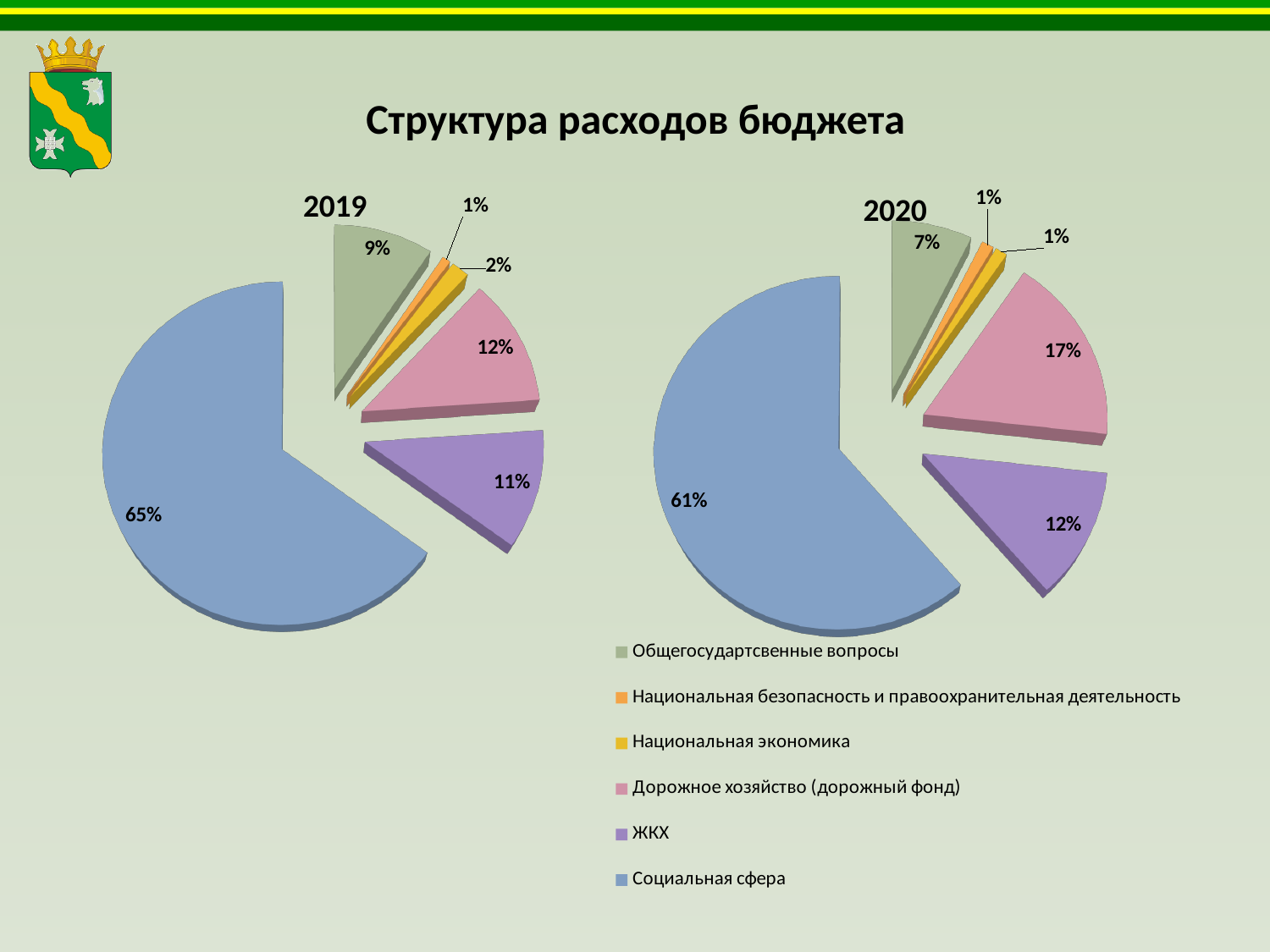
On the 2019 pie chart, which category has the smallest share? Национальная безопасность и правоохранительная деятельность On the 2020 pie chart, what share does Дорожное хозяйство (дорожный фонд) have? 17% What is the title of the slide's charts? Структура расходов бюджета How many categories does the legend list? 6 On the 2020 pie chart, which category has the largest share? Социальная сфера On the 2019 pie chart, what share does ЖКХ have? 11% On the 2019 pie chart, what share does Социальная сфера have? 65% On the 2019 pie chart, what share does Общегосудартсвенные вопросы have? 9% On the 2020 pie chart, what share does Социальная сфера have? 61% What kind of chart is used for the 2019 and 2020 data? Pie chart What is the difference between the share of Дорожное хозяйство (дорожный фонд) in 2020 and in 2019? 5% On the 2019 pie chart, which is larger: the share of Дорожное хозяйство (дорожный фонд) or the share of ЖКХ? Дорожное хозяйство (дорожный фонд)